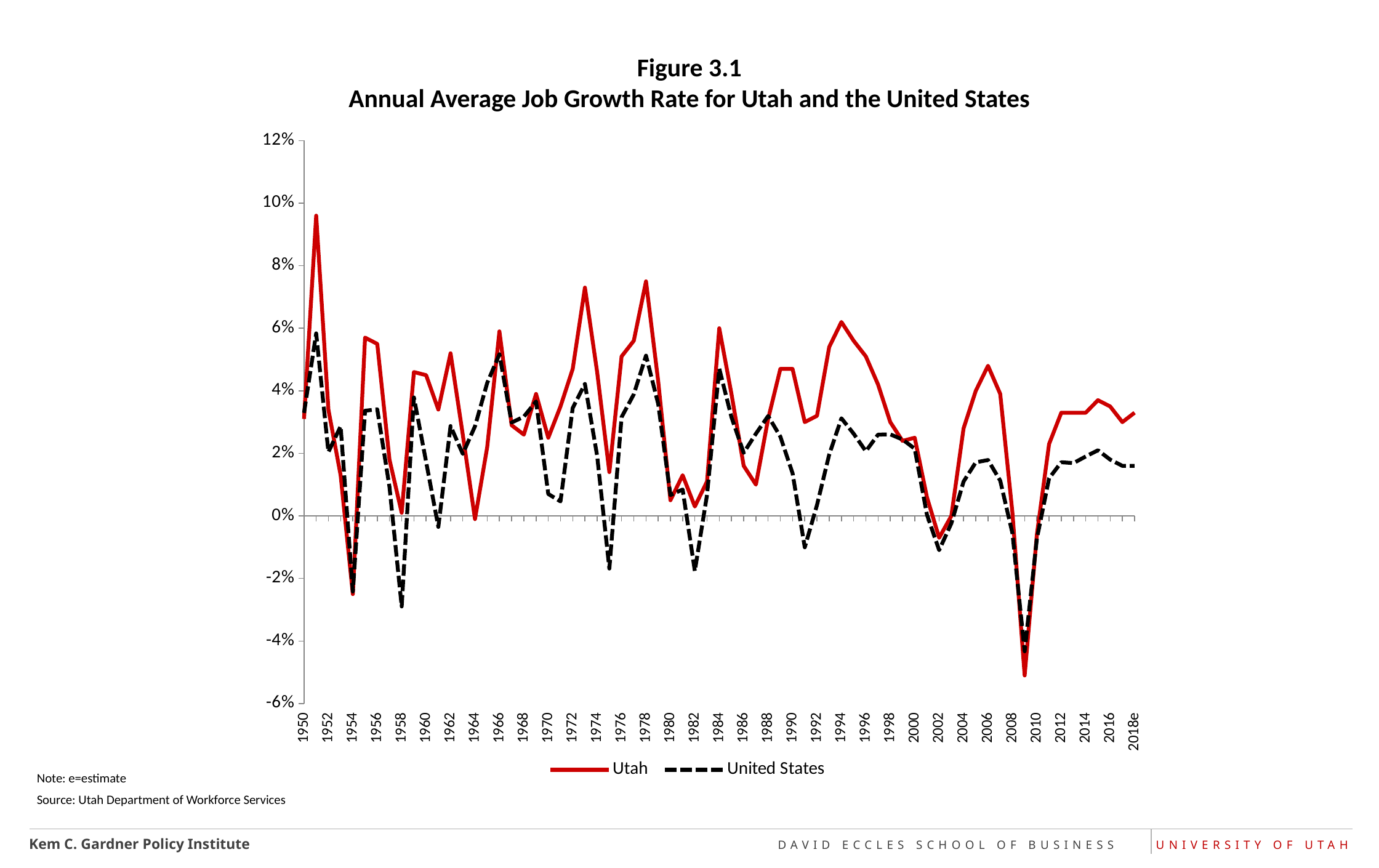
Is the Utah value for 2009 greater or less than -4%? less Is the Utah value for 1951 greater or less than 8%? greater What are the two series shown in the legend? Utah and United States In which year does the United States series reach its lowest value? 2009 In which year does the Utah series reach its lowest value? 2009 Which series has the higher value in 1982, Utah or United States? Utah In which year does the Utah series reach its highest value? 1951 Is the United States value for 2018e greater or less than 2%? less What kind of chart is shown on the slide? line chart Which series has the higher value in 1951, Utah or United States? Utah What is the title of the chart? Annual Average Job Growth Rate for Utah and the United States How many series does the legend list? 2